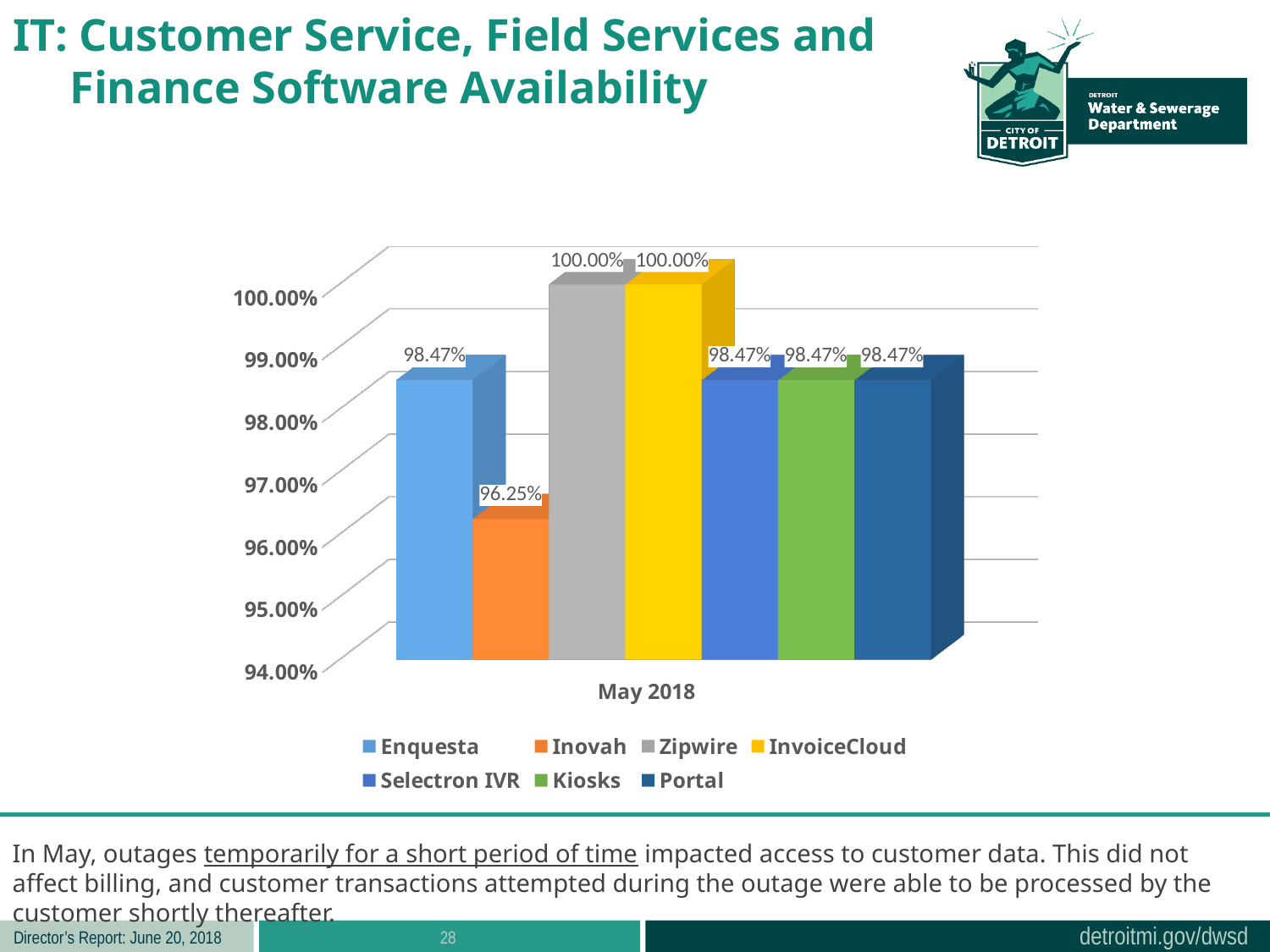
How many series does the legend list? 7 What is the category label shown on the x axis of the chart? May 2018 Which is larger, the value for Zipwire or the value for Kiosks? Zipwire What kind of chart is shown on the slide? bar chart What is the availability value for Enquesta? 98.47% What is the availability value for Zipwire? 100.00% What is the difference between the Enquesta value and the Inovah value? 2.22% Which series has the lowest availability value? Inovah What is the availability value for Inovah? 96.25% Is the value for Inovah greater or less than 97.00%? less What is the difference between the InvoiceCloud value and the Inovah value? 3.75% What is the availability value for Portal? 98.47%